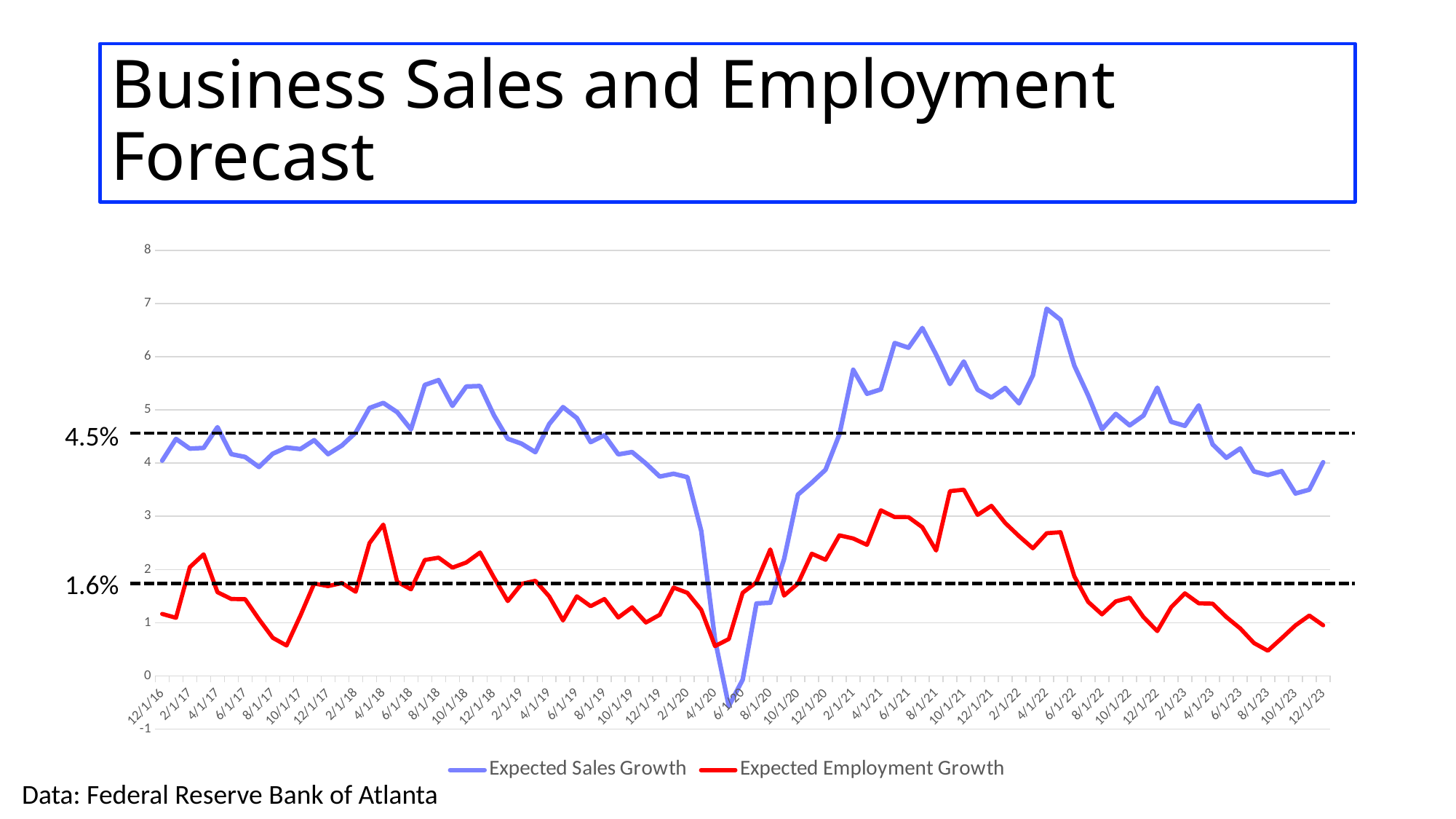
Is the value for Expected Employment Growth at 8/1/23 greater or less than 1? less Is the value for Expected Sales Growth at 4/1/22 greater or less than 6? greater Which series reaches the highest value on the chart? Expected Sales Growth What kind of chart is shown on the slide? Line chart How many series does the legend list? 2 Does Expected Sales Growth rise or fall overall from 4/1/22 to 12/1/23? fall What are the two series named in the legend? Expected Sales Growth and Expected Employment Growth What is the title of the chart on the slide? Business Sales and Employment Forecast At 12/1/23, which series has the larger value, Expected Sales Growth or Expected Employment Growth? Expected Sales Growth Does Expected Employment Growth rise or fall overall from 6/1/20 to 10/1/21? rise Is the value for Expected Sales Growth at 6/1/20 greater or less than 1? less